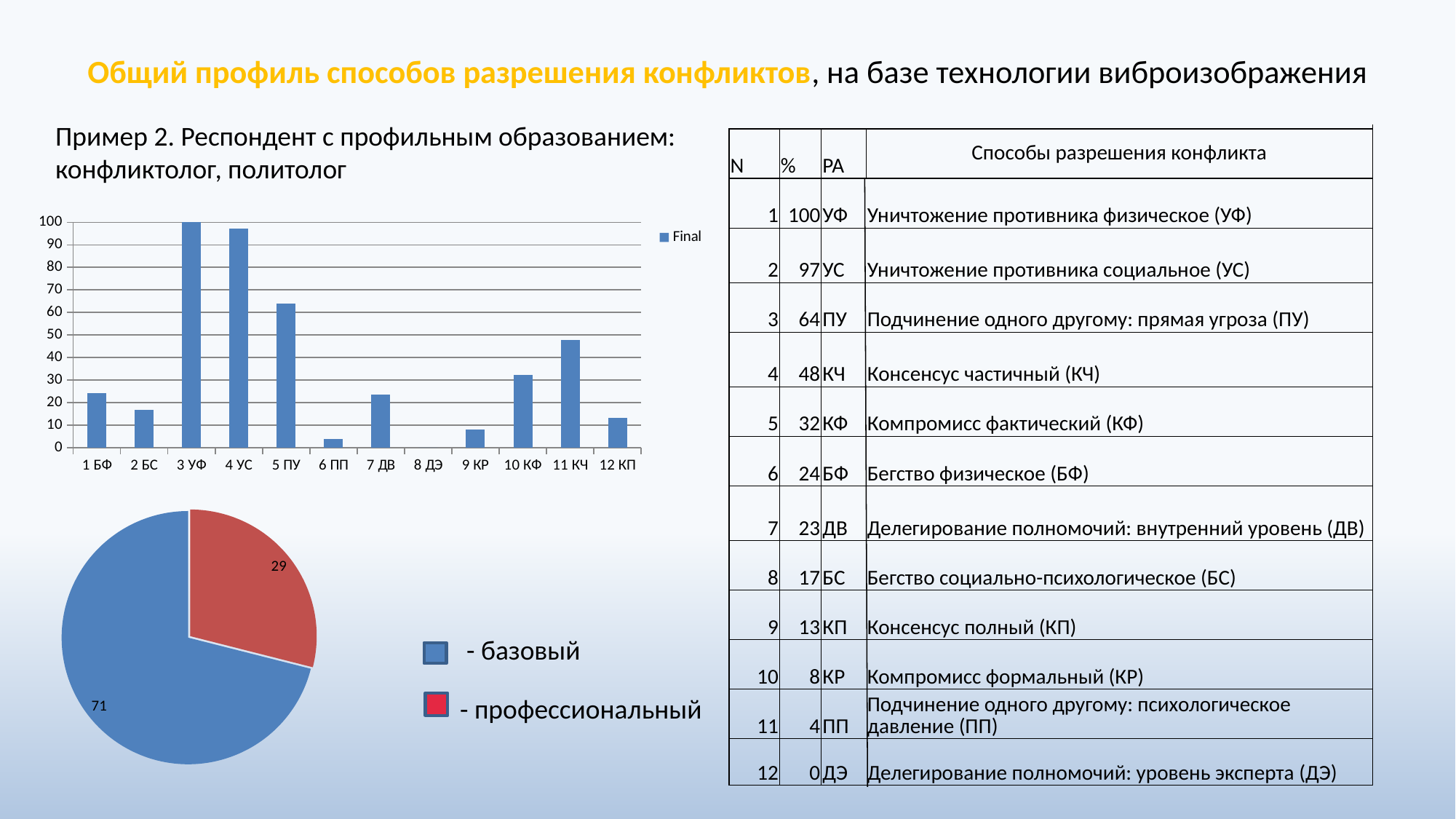
In the bar chart, what is the value for 3 УФ? 100 In the pie chart, what is the value of the blue slice? 71 In the bar chart, what series name does the legend show? Final In the pie chart, what is the value of the red slice? 29 In the bar chart, which category has the highest bar? 3 УФ In the bar chart, is the value for 6 ПП greater or less than 10? less What kind of chart is the lower-left chart on the slide? pie chart In the pie chart, what is the difference between the blue slice and the red slice? 42 In the bar chart, is the value for 5 ПУ greater or less than 60? greater In the bar chart, how many categories are shown on the x axis? 12 What kind of chart is the upper-left chart on the slide? bar chart In the bar chart, which bar is taller, 11 КЧ or 10 КФ? 11 КЧ